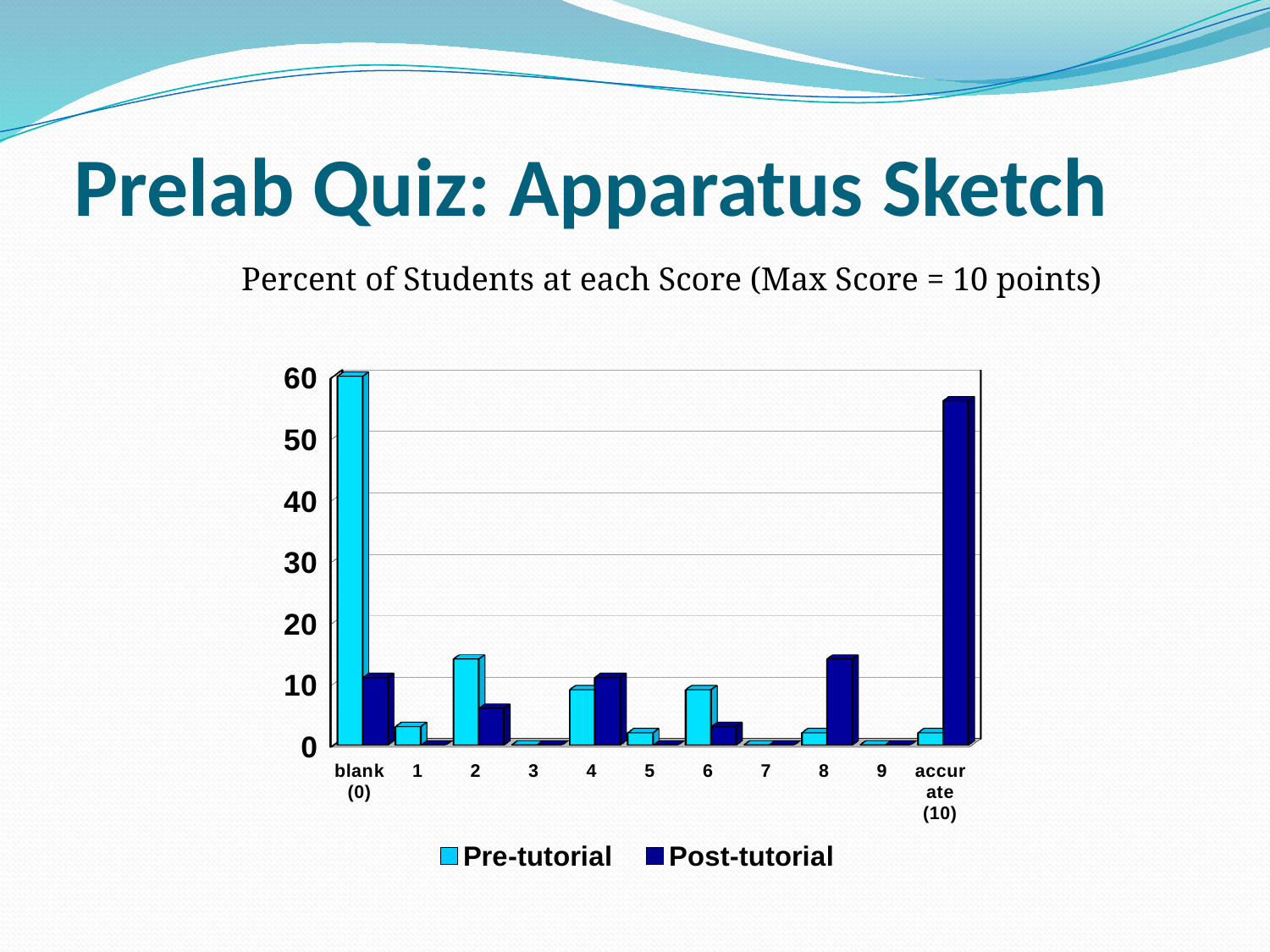
For score 8, which series has the larger value, Pre-tutorial or Post-tutorial? Post-tutorial How many score categories are shown on the x axis? 11 Which score category has the highest Pre-tutorial value? blank (0) What kind of chart is shown on the slide? Bar chart How many series does the legend list? 2 Is the Pre-tutorial value for score 2 greater or less than 20? less For the accurate (10) category, which series has the larger value, Pre-tutorial or Post-tutorial? Post-tutorial For the blank (0) category, which series has the larger value, Pre-tutorial or Post-tutorial? Pre-tutorial What are the two series named in the legend? Pre-tutorial and Post-tutorial Is the Pre-tutorial value for blank (0) greater or less than 50? greater Is the Post-tutorial value for accurate (10) greater or less than 50? greater Which score category has the highest Post-tutorial value? accurate (10)